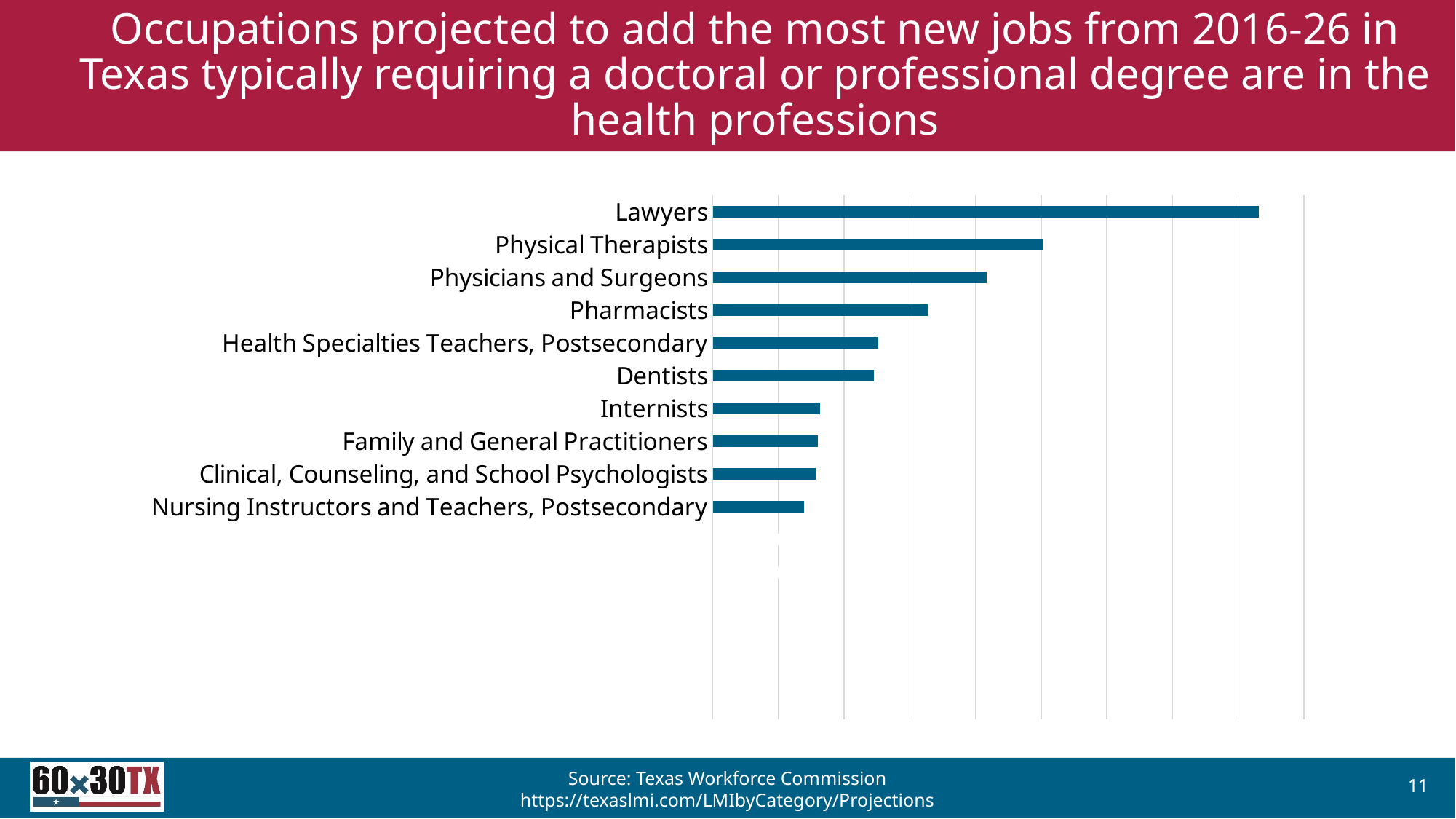
Going from the top of the chart to the bottom, do the bars get longer or shorter? Shorter Which occupation is listed second from the top in the chart? Physical Therapists Which has the larger value, Lawyers or Physical Therapists? Lawyers What kind of chart is shown on the slide? Bar chart What source is cited for the chart data? Texas Workforce Commission Which occupation has the longest bar in the chart? Lawyers Which occupation has the shortest bar in the chart? Nursing Instructors and Teachers, Postsecondary Which has the larger value, Dentists or Nursing Instructors and Teachers, Postsecondary? Dentists How many occupations are listed in the chart? 10 Which has the larger value, Physical Therapists or Physicians and Surgeons? Physical Therapists